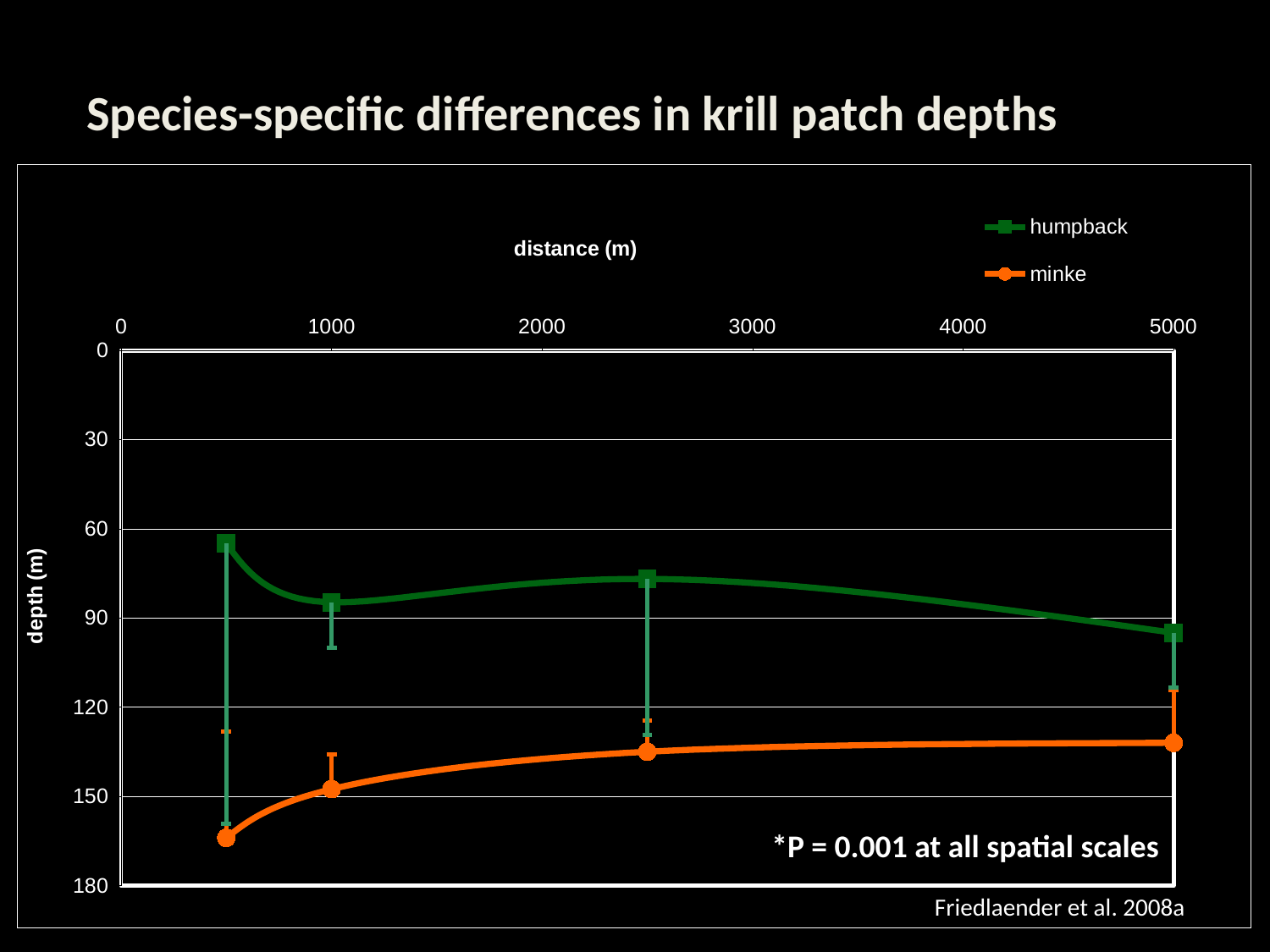
Is the minke depth value at 2500 m distance greater or less than 150? less What is the title of the x axis? distance (m) How many series does the legend list? 2 Is the minke depth value at 5000 m distance greater or less than 120? greater Is the humpback depth value at 2500 m distance greater or less than 90? less How many data points are plotted for the minke series? 4 What kind of chart is shown on the slide? line chart At which distance does the minke series have its highest depth value? 500 At which distance does the humpback series have its lowest depth value? 500 At 500 m distance, which series has the larger depth value, humpback or minke? minke